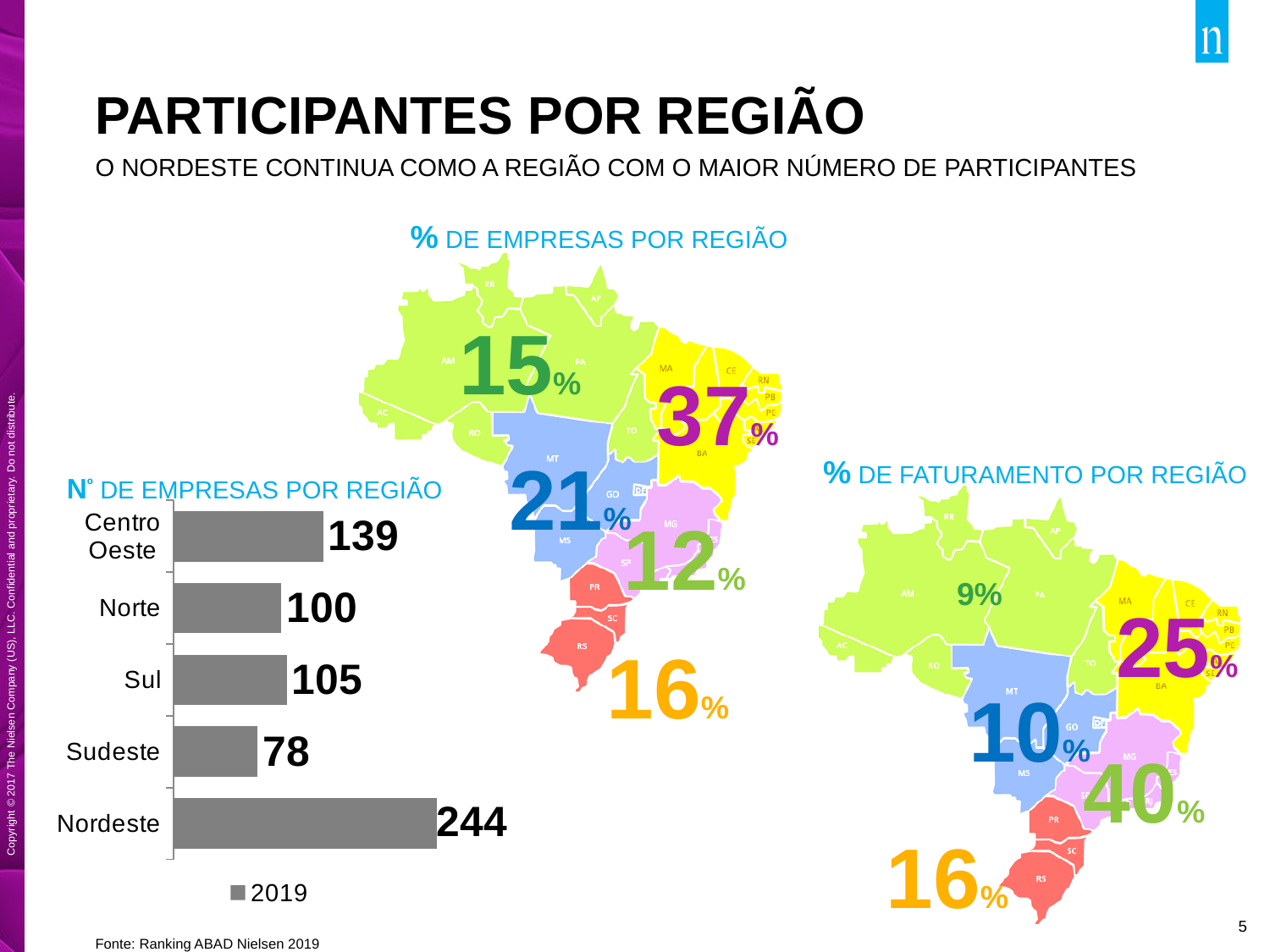
In the "N° DE EMPRESAS POR REGIÃO" chart, what is the value for Centro Oeste? 139 In the "N° DE EMPRESAS POR REGIÃO" chart, what is the difference between Sul and Norte? 5 How many regions are shown in the "N° DE EMPRESAS POR REGIÃO" chart? 5 In the "N° DE EMPRESAS POR REGIÃO" chart, which region has the lowest number of companies? Sudeste In the "N° DE EMPRESAS POR REGIÃO" chart, which region has the highest number of companies? Nordeste What kind of chart is "N° DE EMPRESAS POR REGIÃO"? Bar chart In the "N° DE EMPRESAS POR REGIÃO" chart, what is the difference between Nordeste and Centro Oeste? 105 How many series does the legend of the "N° DE EMPRESAS POR REGIÃO" chart list? 1 In the "N° DE EMPRESAS POR REGIÃO" chart, what is the value for Sudeste? 78 What year does the legend of the "N° DE EMPRESAS POR REGIÃO" chart show? 2019 In the "N° DE EMPRESAS POR REGIÃO" chart, what is the value for Nordeste? 244 In the "N° DE EMPRESAS POR REGIÃO" chart, which is larger, the value for Norte or the value for Sudeste? Norte